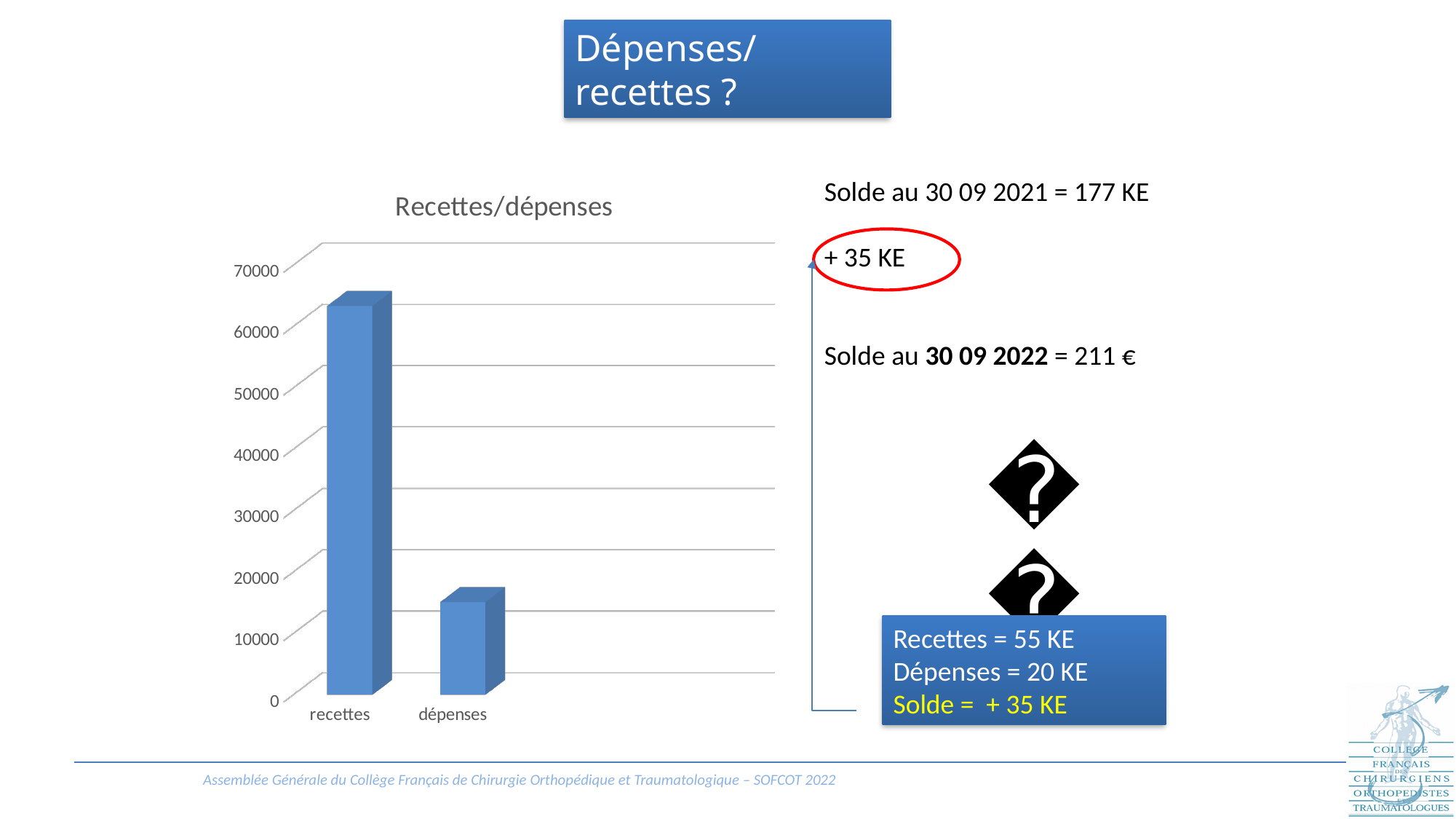
Is the value for dépenses greater or less than 10000? greater Which category has the highest bar in the chart? recettes Which is larger in the chart, recettes or dépenses? recettes Is the value for recettes greater or less than 50000? greater What is the highest value shown on the vertical axis of the chart? 70000 Do the values rise or fall from recettes to dépenses along the x axis? fall Which category has the lowest bar in the chart? dépenses How many categories are plotted in the chart? 2 What is the title of the chart? Recettes/dépenses What type of chart is shown on the slide? bar chart Is the value for dépenses greater or less than 20000? less